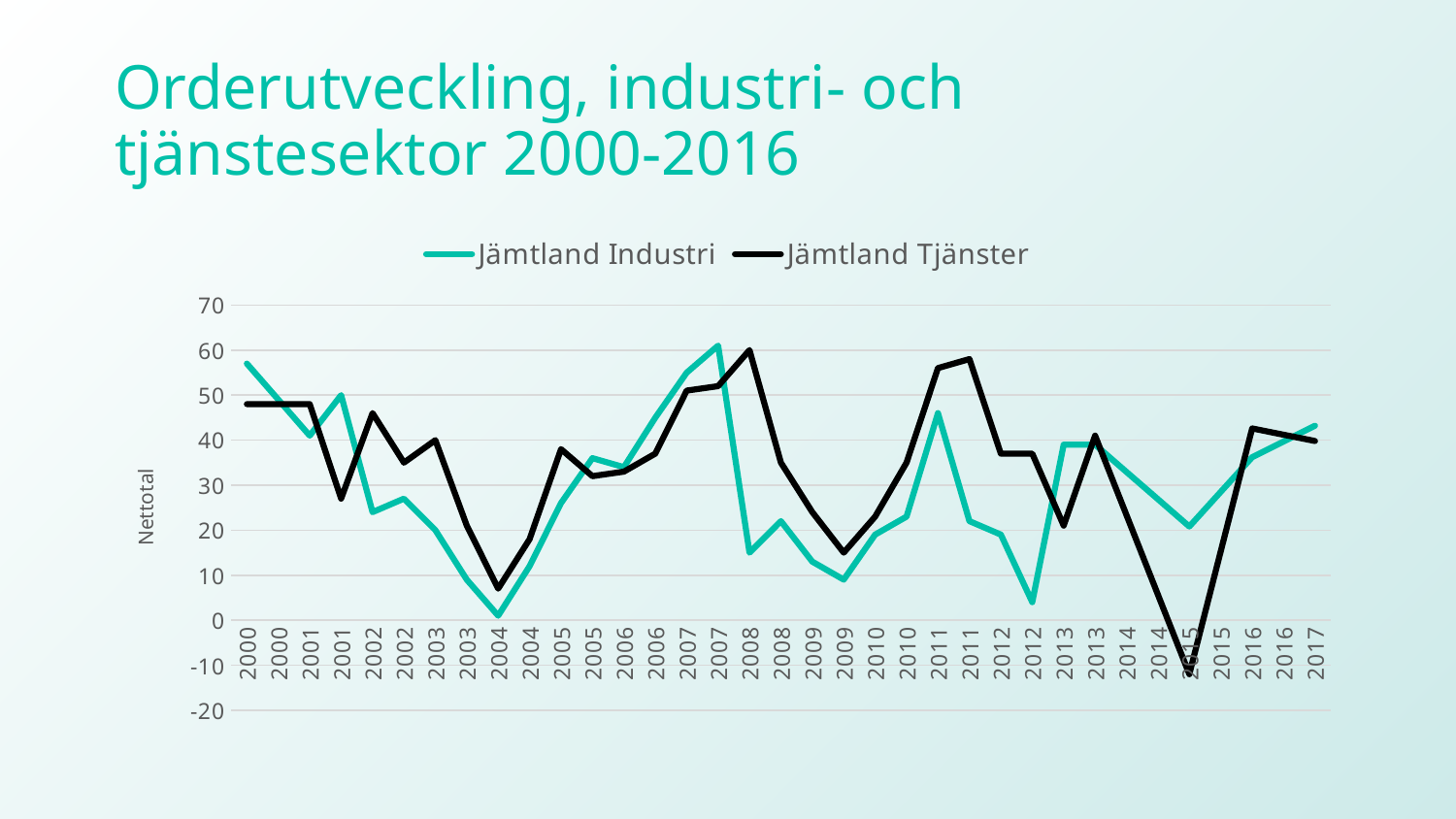
Is the value for Jämtland Industri at the first 2000 point greater or less than 50? greater What is the title of the chart's vertical axis? Nettotal At which year does Jämtland Tjänster reach its lowest value? 2015 Is the value for Jämtland Industri at the first 2008 point greater or less than 20? less Does the Jämtland Tjänster line rise or fall from the second 2013 point to the first 2015 point? Fall At the first 2008 point, which series has the higher value, Jämtland Industri or Jämtland Tjänster? Jämtland Tjänster Is the value for Jämtland Tjänster at the first 2015 point greater or less than 0? less At which year does Jämtland Industri reach its lowest value? 2004 How many series does the legend list? 2 Which series is drawn in black? Jämtland Tjänster What kind of chart is shown on the slide? Line chart